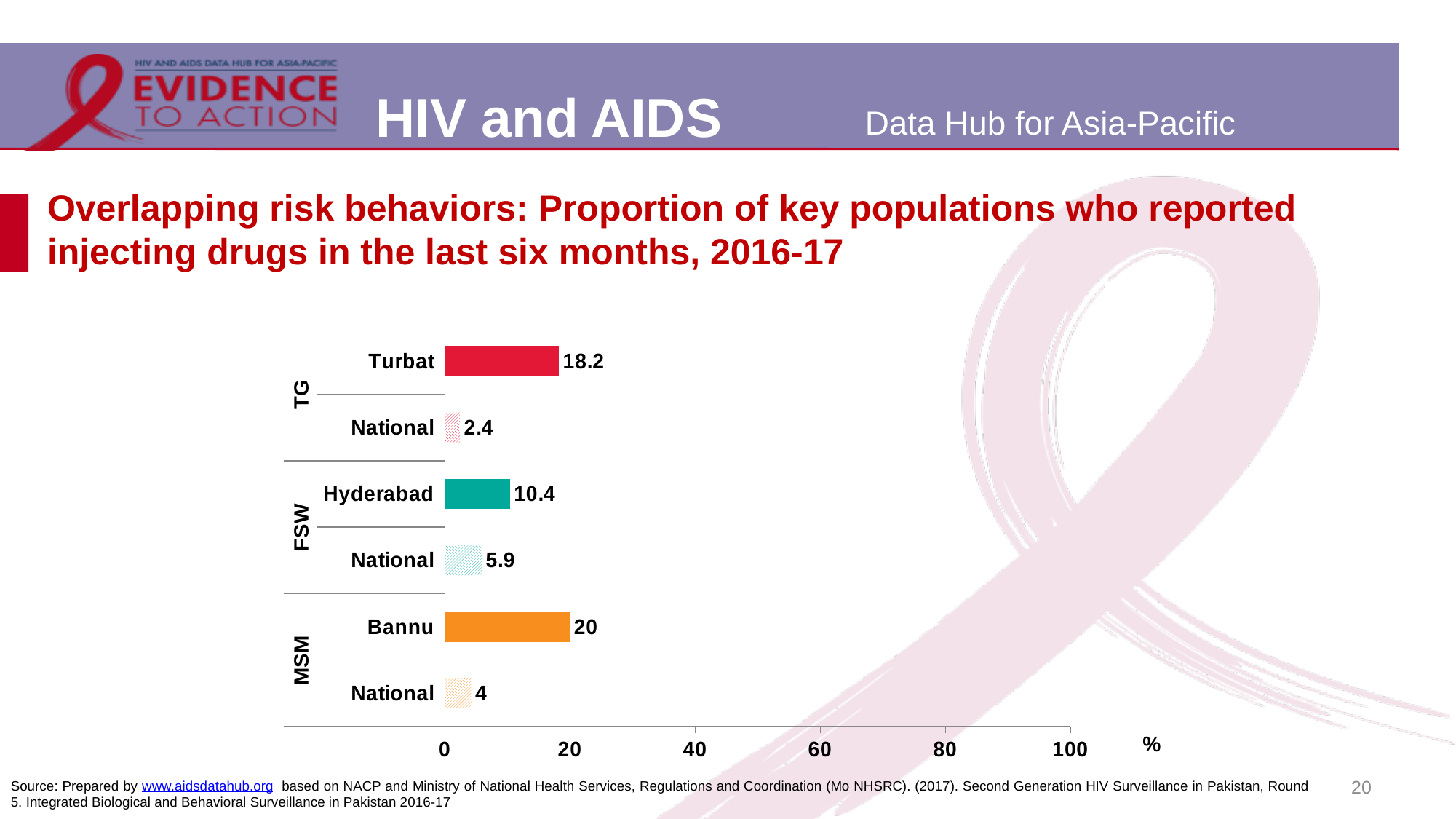
What kind of chart is shown on the slide? Bar chart What is the difference between the Bannu value and the MSM National value? 16 What is the value for Hyderabad in the FSW group? 10.4 What is the value for Bannu in the MSM group? 20 What is the National value for FSW? 5.9 Which bar has the lowest value on the chart? National (TG) What unit is shown at the end of the x axis? % How many bars are plotted on the chart? 6 Which is larger, the value for Hyderabad or the value for Turbat? Turbat Which bar has the highest value on the chart? Bannu (MSM) What is the difference between the Turbat value and the TG National value? 15.8 What is the value for Turbat in the TG group? 18.2